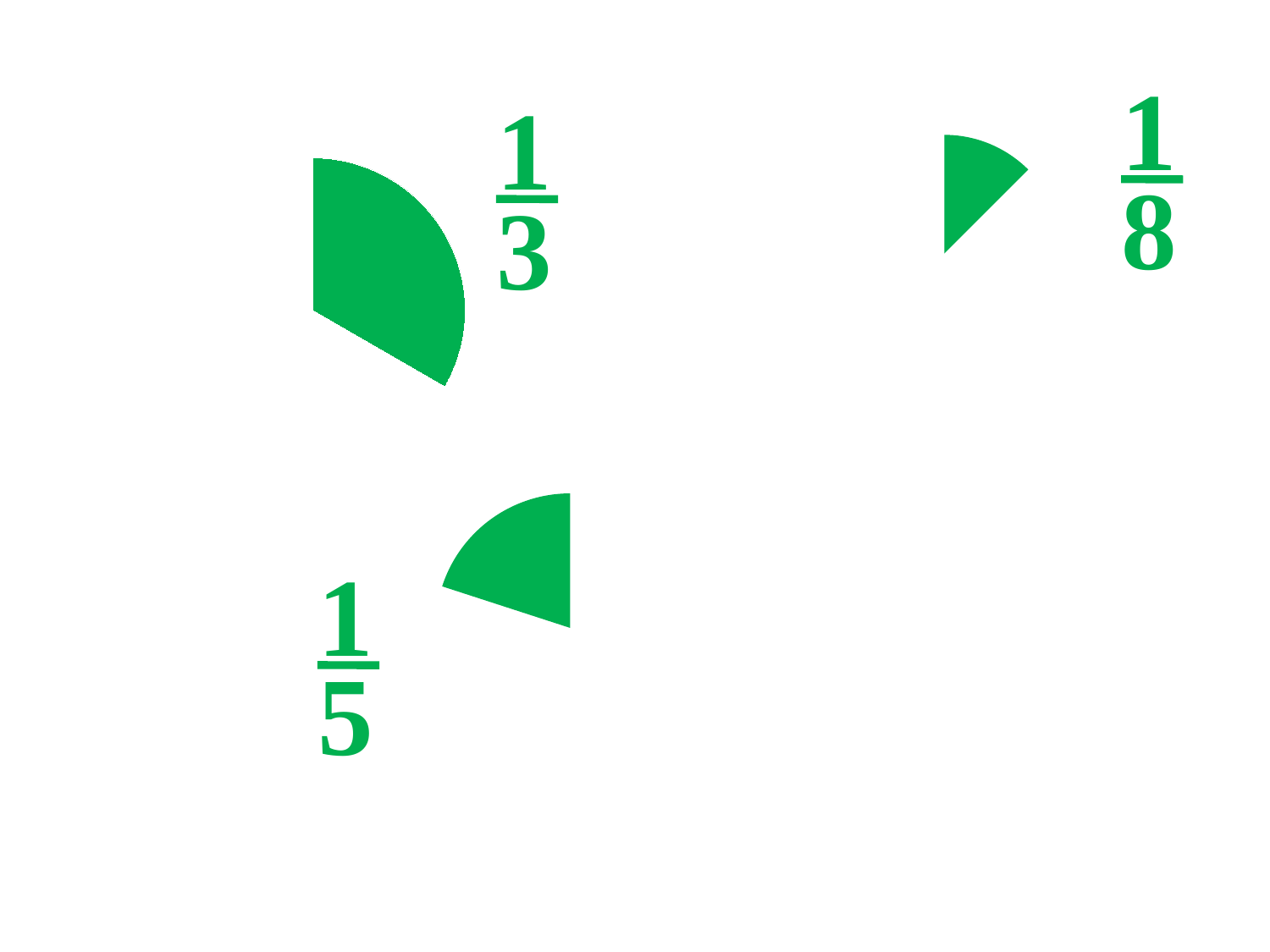
What fraction is printed next to the bottom green sector? 1/5 Which is larger, the sector labelled 1/5 or the sector labelled 1/8? 1/5 How many green sectors are shown on the slide? 3 Which labelled fraction on the slide is the largest? 1/3 Which labelled fraction on the slide is the smallest? 1/8 What fraction is printed next to the top-right green sector? 1/8 Which is larger, the sector labelled 1/3 or the sector labelled 1/8? 1/3 What fraction is printed next to the top-left green sector? 1/3 Which sector is positioned at the bottom of the slide, by its label? 1/5 What colour are the sectors on the slide? Green